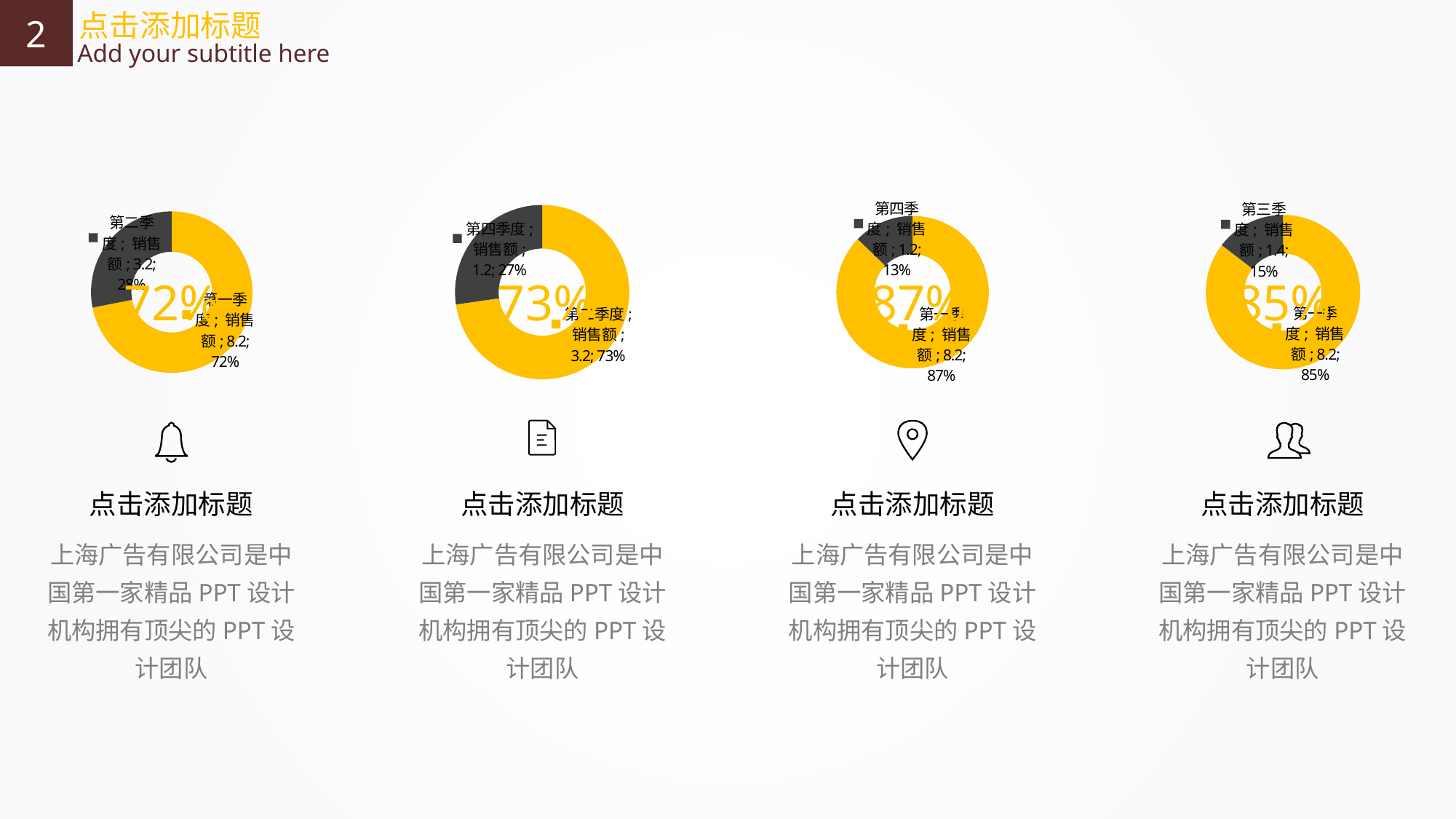
How many slices does the third doughnut chart from the left have? 2 What percentage is printed in the centre of the leftmost doughnut chart? 72% What kind of chart is the leftmost chart on the slide? doughnut chart In the leftmost doughnut chart, what share does the dark grey slice (第二季度) have? 28% In the rightmost doughnut chart, which slice is larger, the yellow slice or the dark grey slice? the yellow slice In the second doughnut chart from the left, what share does the dark grey slice (第四季度) have? 27% What percentage is printed in the centre of the second doughnut chart from the left? 73% In the third doughnut chart from the left, what is the sales value (销售额) shown for the dark grey slice (第四季度)? 1.2 What percentage is printed in the centre of the third doughnut chart from the left? 87% What percentage is printed in the centre of the rightmost doughnut chart? 85% In the rightmost doughnut chart, what is the sales value (销售额) shown for the dark grey slice (第三季度)? 1.4 What colour is the larger slice in each of the four doughnut charts? yellow